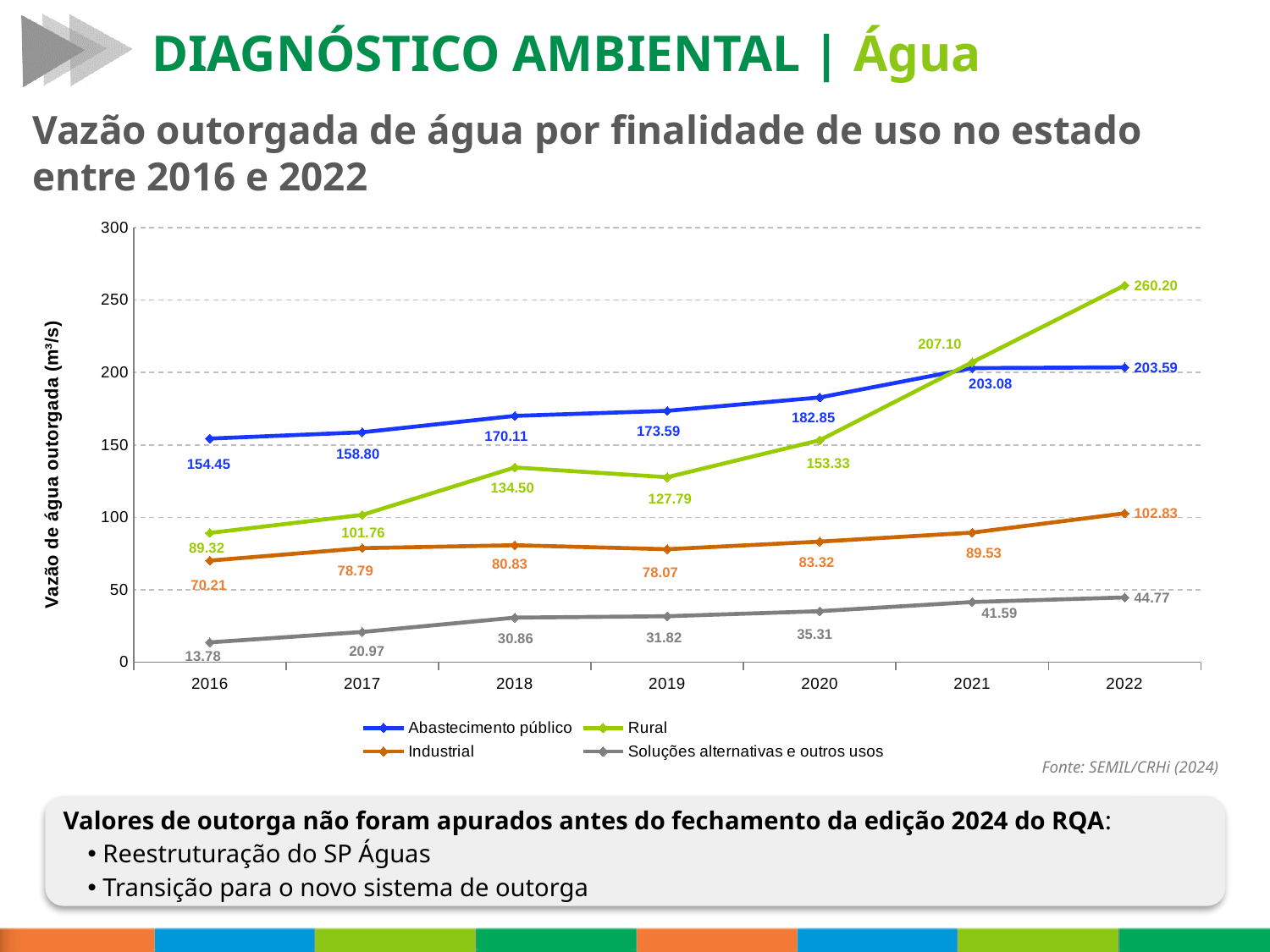
In 2021, which is larger: Rural or Abastecimento público? Rural Is the value for Industrial in 2022 greater or less than 100? greater What is the value for Rural in 2022? 260.20 How many years are plotted on the x axis? 7 In which year does the Rural series reach its highest value? 2022 In which year is the Abastecimento público series at its lowest? 2016 What is the difference between the Rural values for 2022 and 2021? 53.10 What is the value for Soluções alternativas e outros usos in 2016? 13.78 Does the Soluções alternativas e outros usos series rise or fall from 2016 to 2022? rises What is the value for Industrial in 2019? 78.07 How many series does the legend list? 4 What kind of chart is shown on the slide? line chart